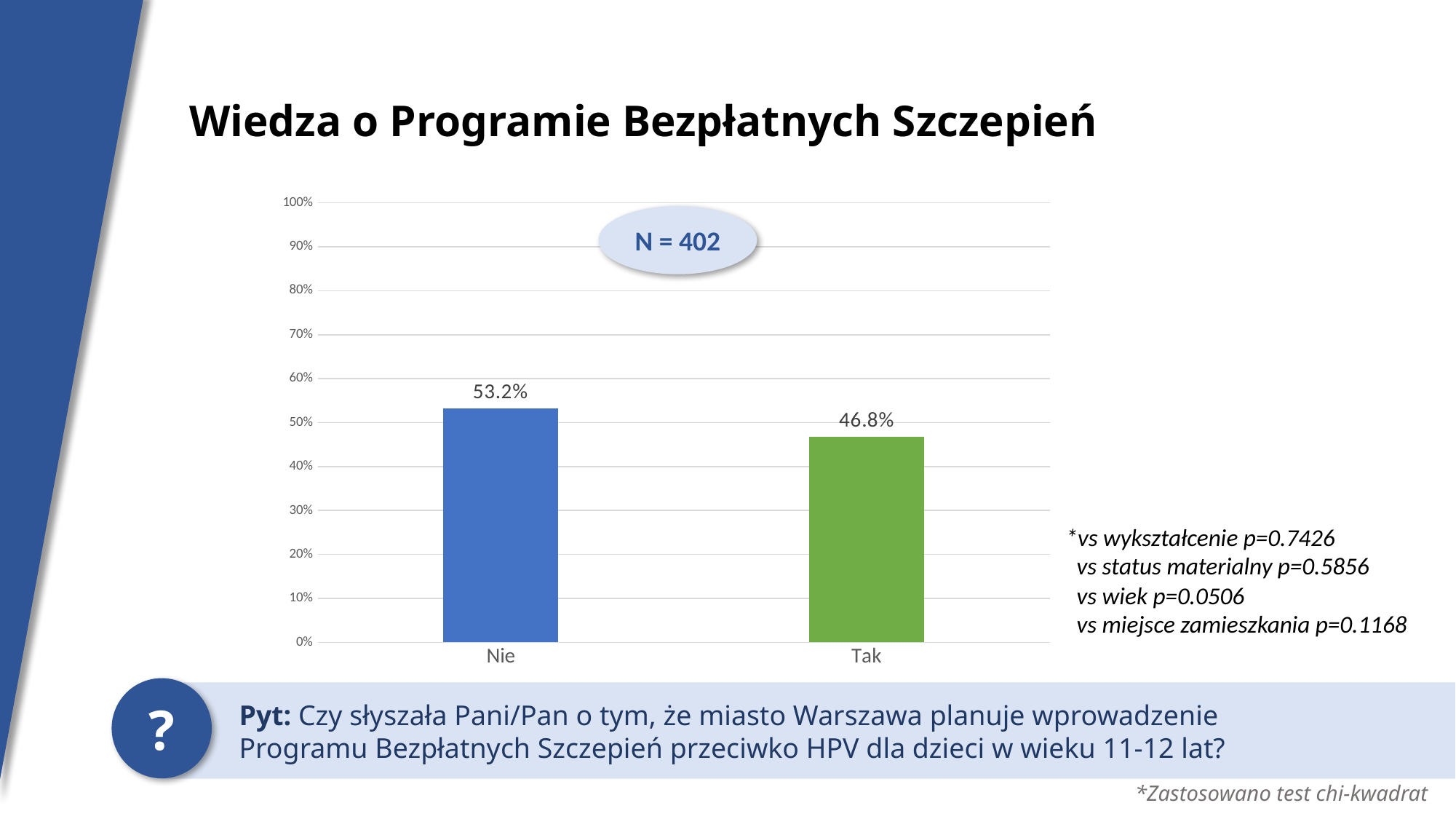
How many categories are shown on the x axis? 2 What is the value for "Nie"? 53.2% What sample size (N) is shown on the chart? N = 402 Which is larger, the value for "Nie" or the value for "Tak"? Nie What is the difference between the values for "Nie" and "Tak"? 6.4% What is the value for "Tak"? 46.8% What colour is the bar for "Tak"? green Is the value for "Nie" greater or less than 50%? greater Which category has the highest value? Nie Is the value for "Tak" greater or less than 50%? less Which category has the lowest value? Tak What kind of chart is shown on the slide? bar chart